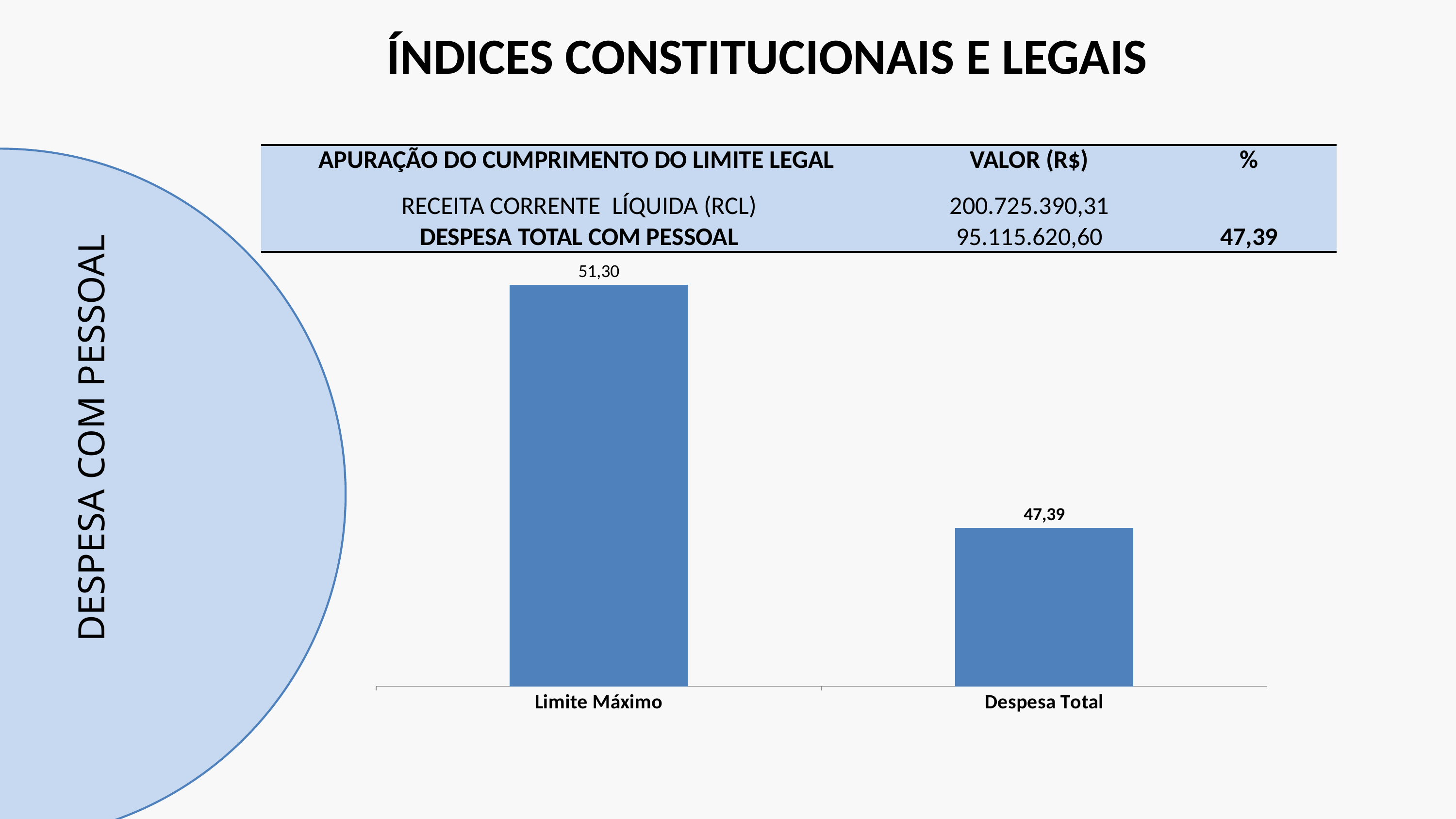
What is the title of the slide containing the chart? ÍNDICES CONSTITUCIONAIS E LEGAIS Which category has the lowest value? Despesa Total Which category has the highest value? Limite Máximo What is the value shown for Despesa Total? 47,39 Do the values rise or fall from Limite Máximo to Despesa Total? Fall What colour are the bars in the chart? Blue What is the value shown for Limite Máximo? 51,30 What kind of chart is shown on the slide? Bar chart What is the difference between the values for Limite Máximo and Despesa Total? 3,91 Which is larger, the value for Limite Máximo or the value for Despesa Total? Limite Máximo How many categories are plotted in the chart? 2